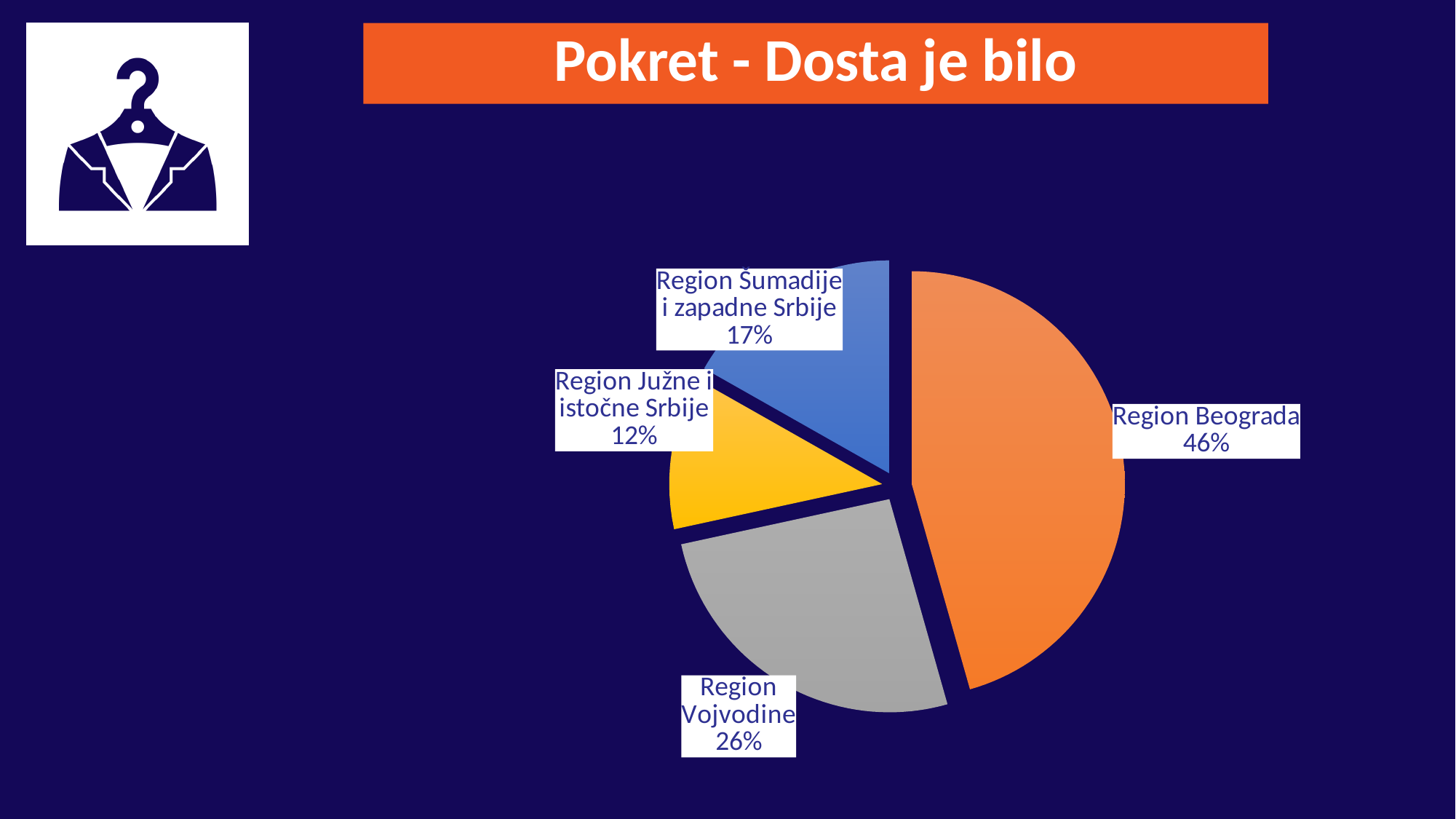
What is the difference in percentage points between Region Beograda and Region Vojvodine? 20 What is the title shown above the chart on the slide? Pokret - Dosta je bilo What kind of chart is shown on the slide? pie chart How many slices does the pie chart have? 4 What share of the pie does Region Beograda have? 46% Which is larger, the share for Region Šumadije i zapadne Srbije or the share for Region Južne i istočne Srbije? Region Šumadije i zapadne Srbije What share of the pie does Region Šumadije i zapadne Srbije have? 17% What share of the pie does Region Vojvodine have? 26% Which region has the smallest slice of the pie? Region Južne i istočne Srbije What share of the pie does Region Južne i istočne Srbije have? 12% What colour is the slice for Region Vojvodine? grey Which region has the largest slice of the pie? Region Beograda